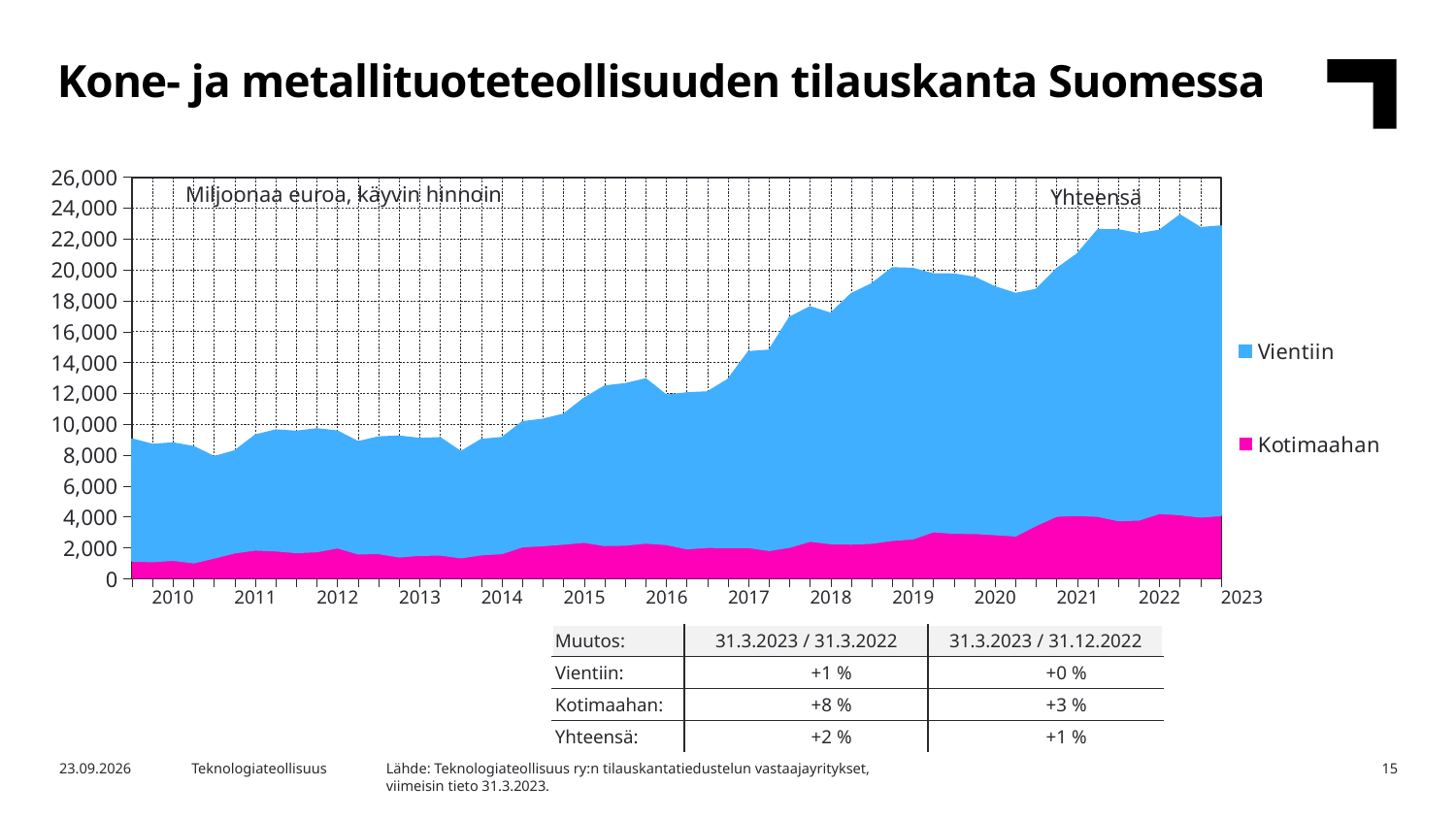
Is the Kotimaahan value at the start of 2010 greater or less than 2,000? less Is the total order backlog in 2013 greater or less than 10,000? less Which series is larger throughout the chart, Vientiin or Kotimaahan? Vientiin What are the two series named in the chart legend? Vientiin and Kotimaahan How many series does the chart legend list? 2 Is the Kotimaahan value in 2022 greater or less than 2,000? greater What kind of chart is shown on the slide? Stacked area chart How many year labels are shown on the x axis of the chart? 14 Does the total order backlog generally rise or fall from 2010 to 2023? rise What unit label is shown inside the chart area at the top left? Miljoonaa euroa, käyvin hinnoin